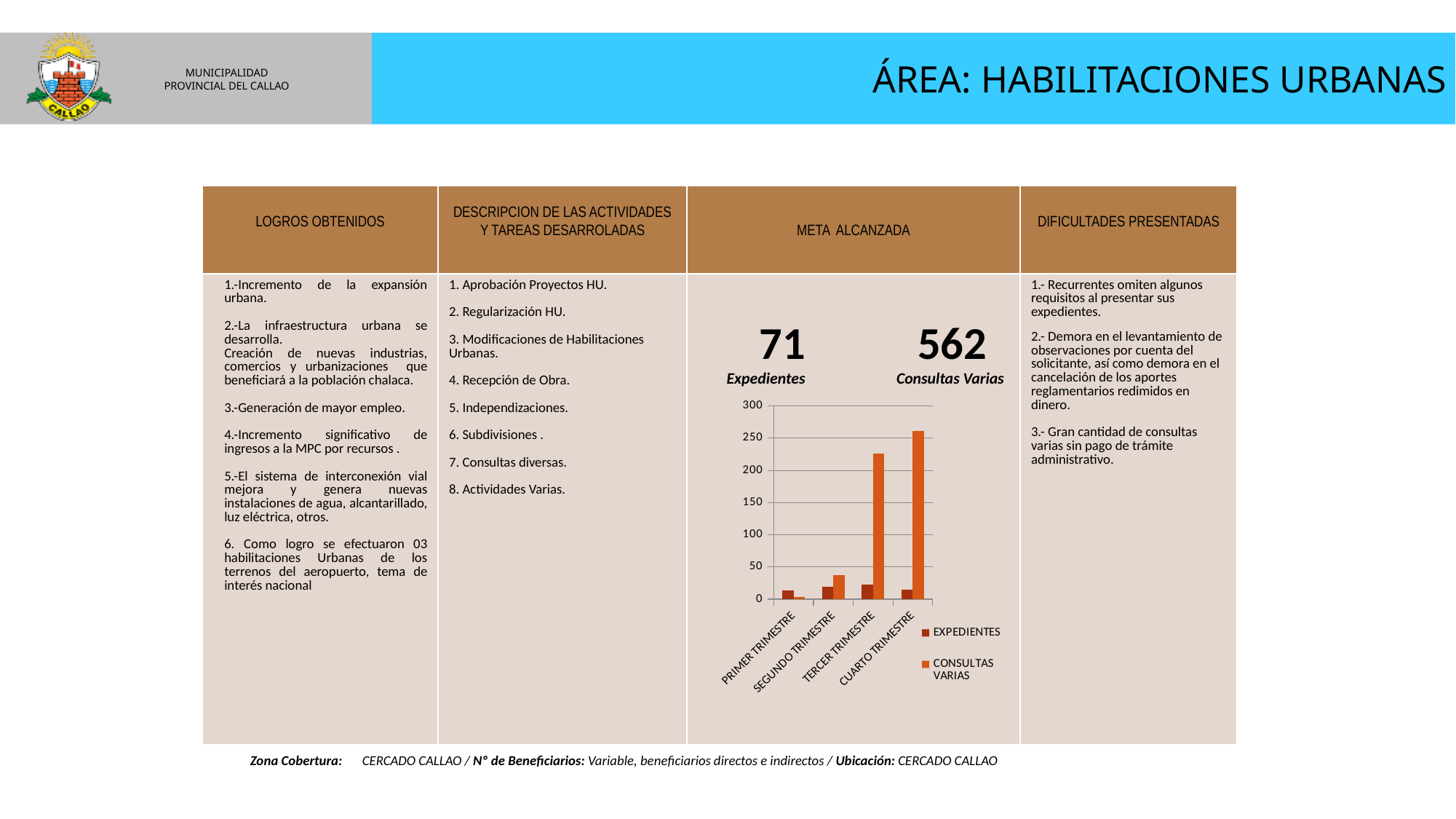
Is the CONSULTAS VARIAS value for SEGUNDO TRIMESTRE greater or less than 50? less Is the EXPEDIENTES value for TERCER TRIMESTRE greater or less than 50? less How many categories (trimestres) are shown on the x axis of the chart? 4 In which trimestre is the CONSULTAS VARIAS value highest? CUARTO TRIMESTRE How many series does the chart legend list? 2 What are the two series named in the chart legend? EXPEDIENTES and CONSULTAS VARIAS Do the CONSULTAS VARIAS values rise or fall from PRIMER TRIMESTRE to CUARTO TRIMESTRE? rise Is the CONSULTAS VARIAS value for TERCER TRIMESTRE greater or less than 200? greater What kind of chart is shown in the META ALCANZADA column? Bar chart In which trimestre is the CONSULTAS VARIAS value lowest? PRIMER TRIMESTRE Which is larger in TERCER TRIMESTRE, EXPEDIENTES or CONSULTAS VARIAS? CONSULTAS VARIAS